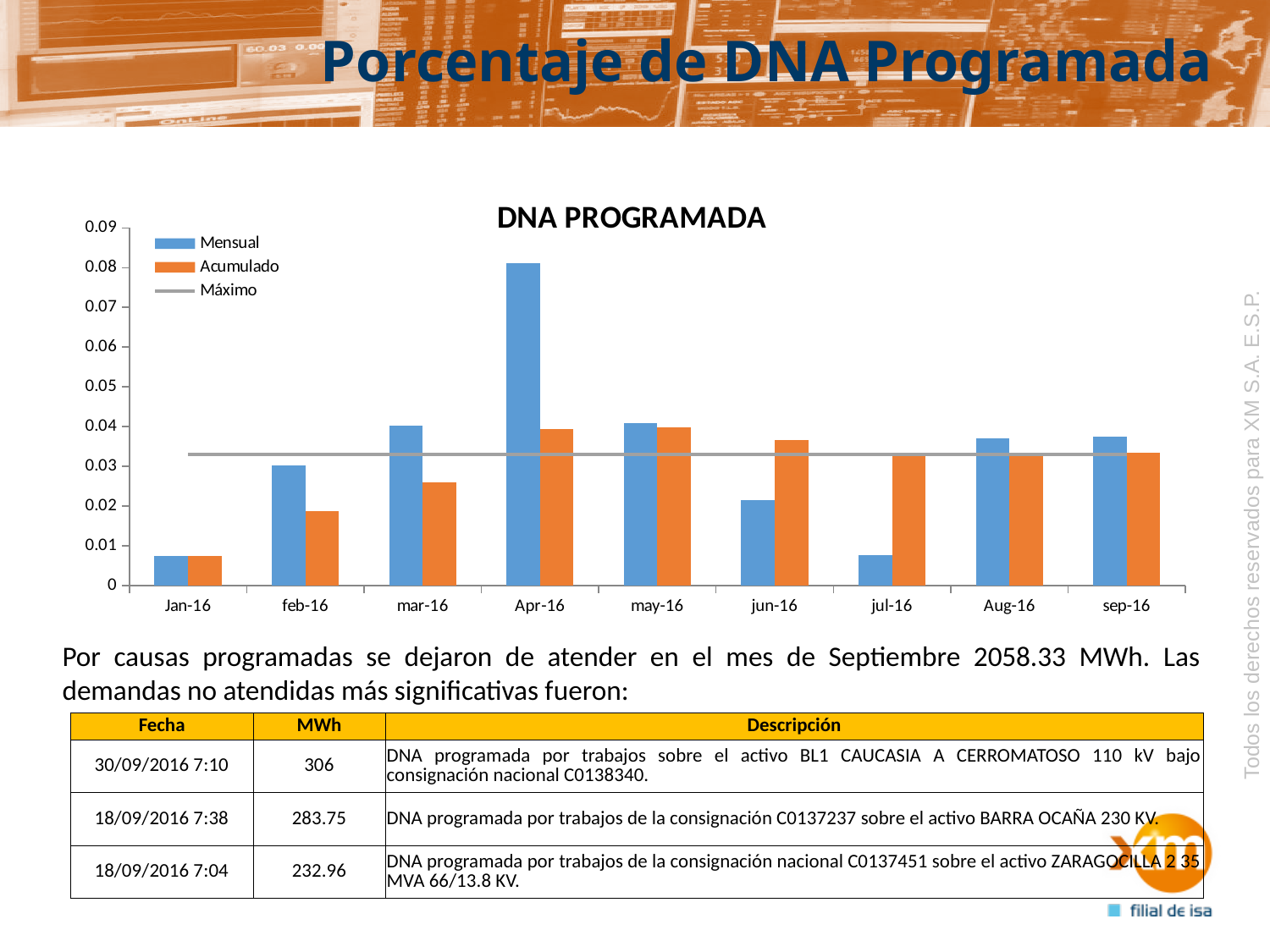
How many series does the legend of the DNA PROGRAMADA chart list? 3 Is the Mensual value for feb-16 greater or less than 0.04? less What are the three entries in the legend of the DNA PROGRAMADA chart? Mensual, Acumulado, Máximo In Apr-16, which is larger, the Mensual value or the Acumulado value? Mensual Is the Acumulado value for Jan-16 greater or less than 0.01? less What kind of chart is the DNA PROGRAMADA chart? bar chart How many months are shown on the x axis of the DNA PROGRAMADA chart? 9 Is the Mensual value for Apr-16 greater or less than 0.07? greater Which month has the highest Mensual value in the DNA PROGRAMADA chart? Apr-16 Does the Acumulado series rise or fall from Jan-16 to may-16? rise In jul-16, which is larger, the Mensual value or the Acumulado value? Acumulado